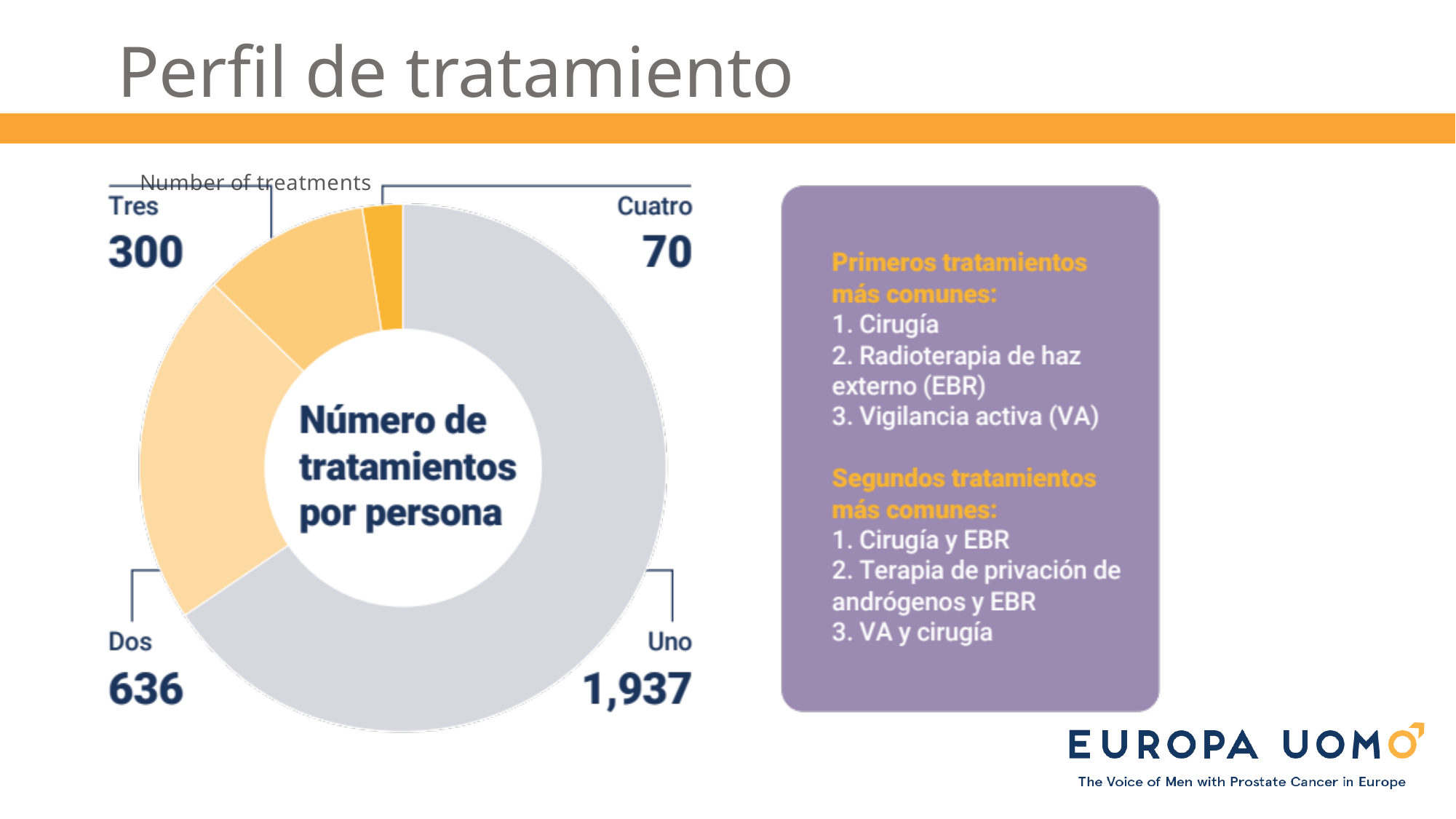
What value is shown for "Uno" in the donut chart? 1,937 Which is larger, the value for "Tres" or the value for "Cuatro"? Tres What text appears in the centre of the donut chart? Número de tratamientos por persona How many categories are shown in the donut chart? 4 What is the difference between the values for "Uno" and "Dos"? 1,301 Which category has the smallest value in the donut chart? Cuatro What value is shown for "Dos" in the donut chart? 636 What value is shown for "Tres" in the donut chart? 300 What value is shown for "Cuatro" in the donut chart? 70 What is the difference between the values for "Dos" and "Tres"? 336 What kind of chart is shown on the slide? Donut (pie) chart Which category has the largest value in the donut chart? Uno